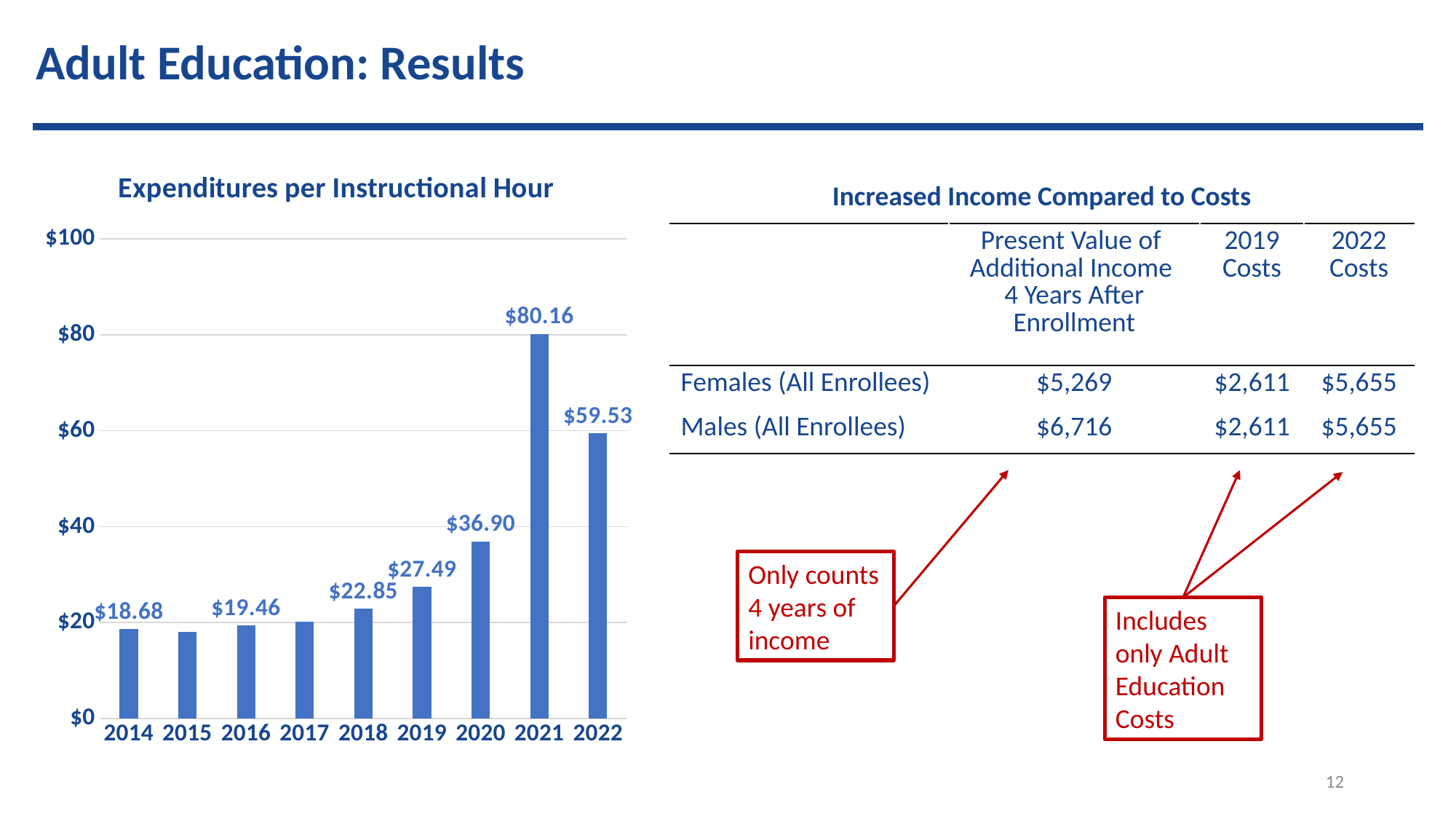
Do expenditures per instructional hour rise or fall from 2014 to 2021? rise What is the difference between the 2021 and 2022 expenditures per instructional hour? $20.63 Is the expenditure per instructional hour for 2015 greater or less than $20? less What type of chart is used to show Expenditures per Instructional Hour? bar chart What is the difference between the 2020 and 2019 expenditures per instructional hour? $9.41 How many years are shown in the Expenditures per Instructional Hour chart? 9 Which year has a higher expenditure per instructional hour, 2019 or 2020? 2020 Is the expenditure per instructional hour for 2017 greater or less than $40? less Which year has the highest expenditure per instructional hour? 2021 What is the expenditure per instructional hour in 2021? $80.16 What is the expenditure per instructional hour in 2022? $59.53 What is the expenditure per instructional hour in 2018? $22.85